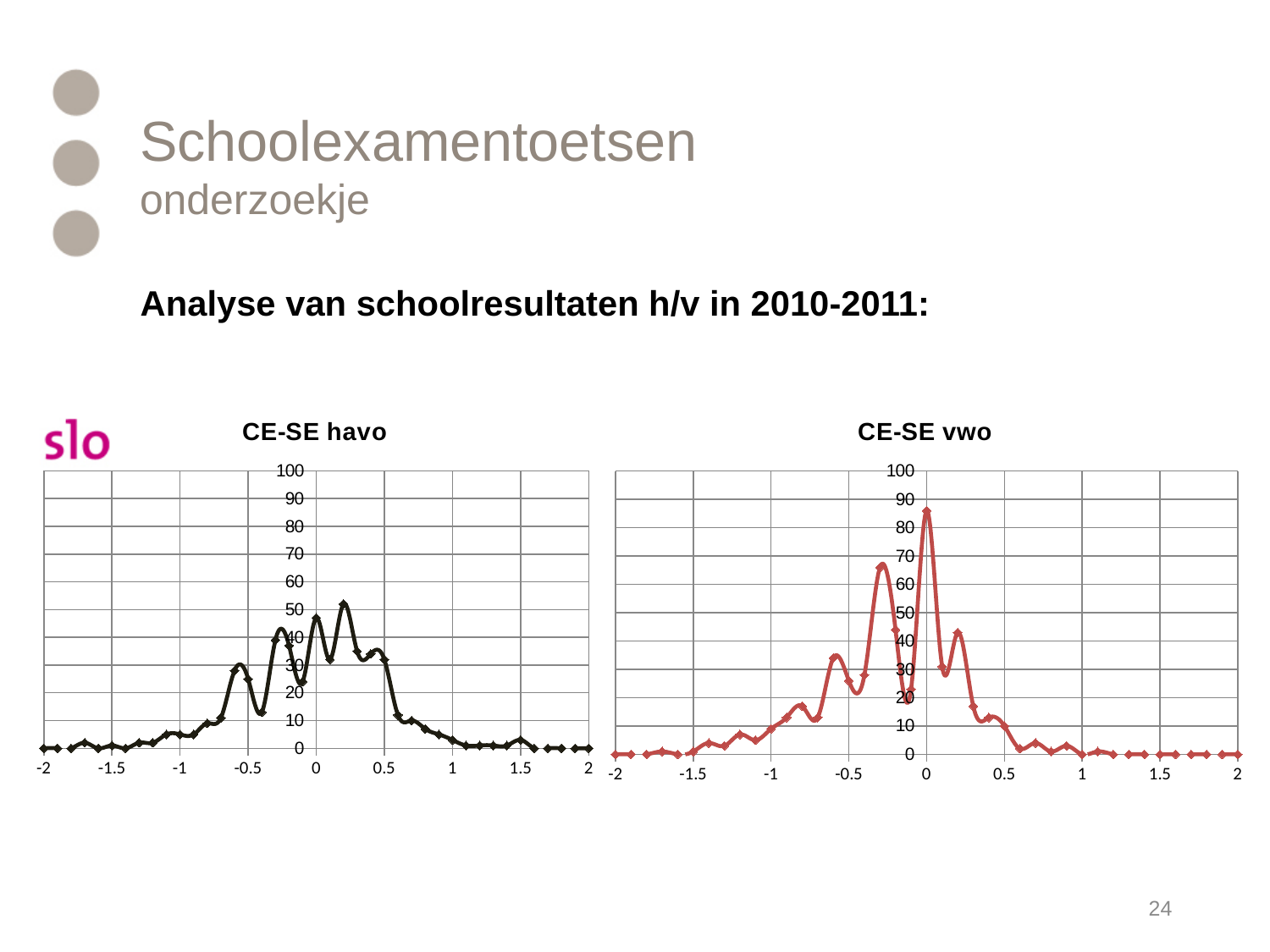
What colour is the line in the CE-SE vwo chart? red In the CE-SE havo chart, is the value at x = 1.5 greater or less than 10? less In the CE-SE havo chart, is the value at x = 0 greater or less than 40? greater What is the highest value shown on the vertical axis of the CE-SE havo chart? 100 In the CE-SE havo chart, is the value at x = -2 greater or less than 10? less In the CE-SE vwo chart, at which x value does the line reach its highest point? 0 What kind of chart is the CE-SE vwo chart? line chart What kind of chart is the CE-SE havo chart? line chart Which chart reaches a higher peak value, CE-SE havo or CE-SE vwo? CE-SE vwo